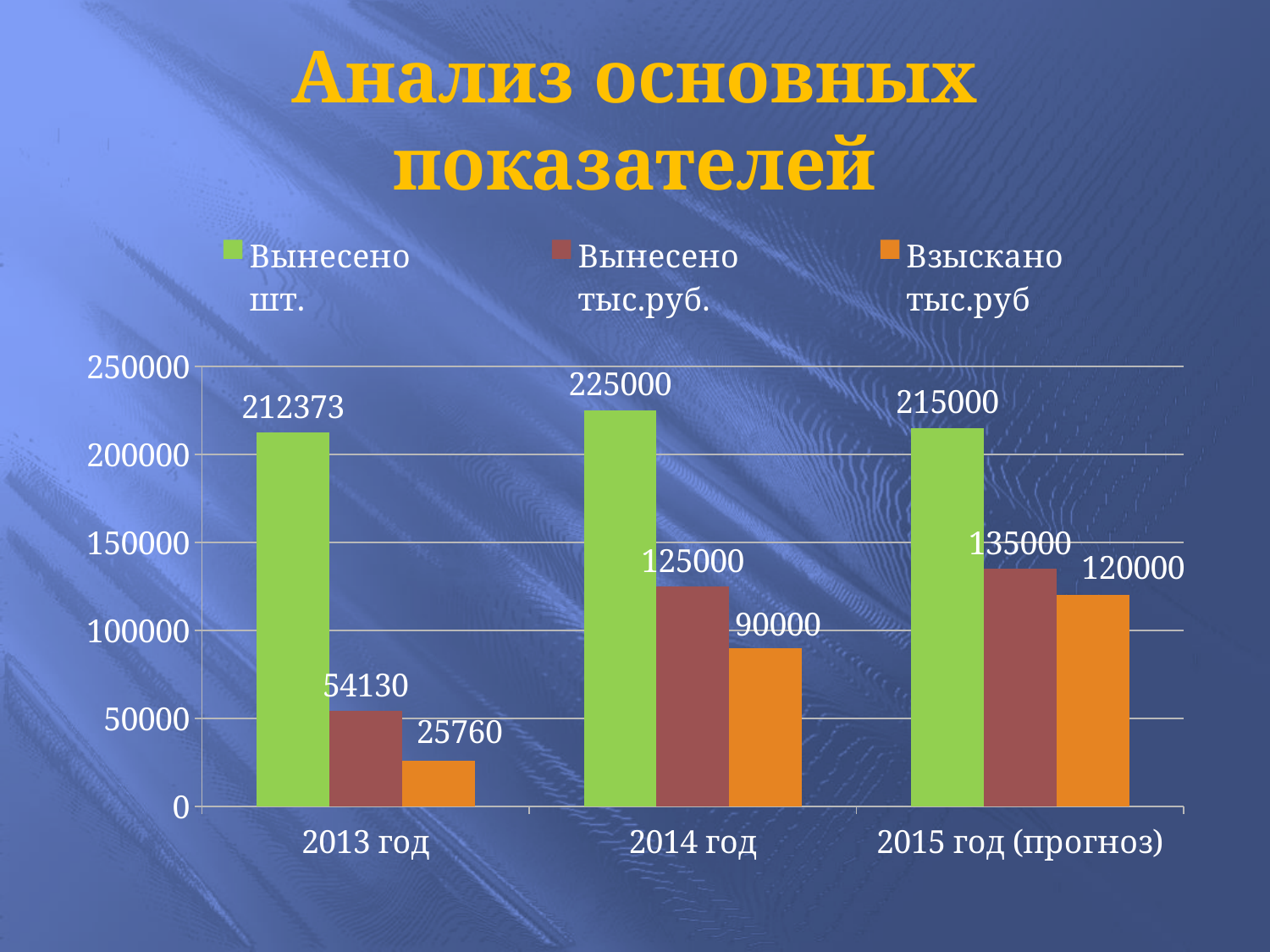
Which year has the highest value for "Вынесено шт."? 2014 год What is the value of "Взыскано тыс.руб" for 2014 год? 90000 Which is larger: "Взыскано тыс.руб" in 2015 год (прогноз) or "Вынесено тыс.руб." in 2014 год? Вынесено тыс.руб. in 2014 год What is the difference between "Вынесено тыс.руб." and "Взыскано тыс.руб" in 2014 год? 35000 Which year has the lowest value for "Взыскано тыс.руб"? 2013 год What is the value of "Вынесено шт." for 2013 год? 212373 How many year categories are shown on the x axis? 3 What colour are the bars for "Вынесено шт."? Green What kind of chart is shown on the slide? Bar chart What is the value of "Вынесено тыс.руб." for 2015 год (прогноз)? 135000 How many series does the legend list? 3 Does the value of "Взыскано тыс.руб" rise or fall from 2013 год to 2015 год (прогноз)? Rise